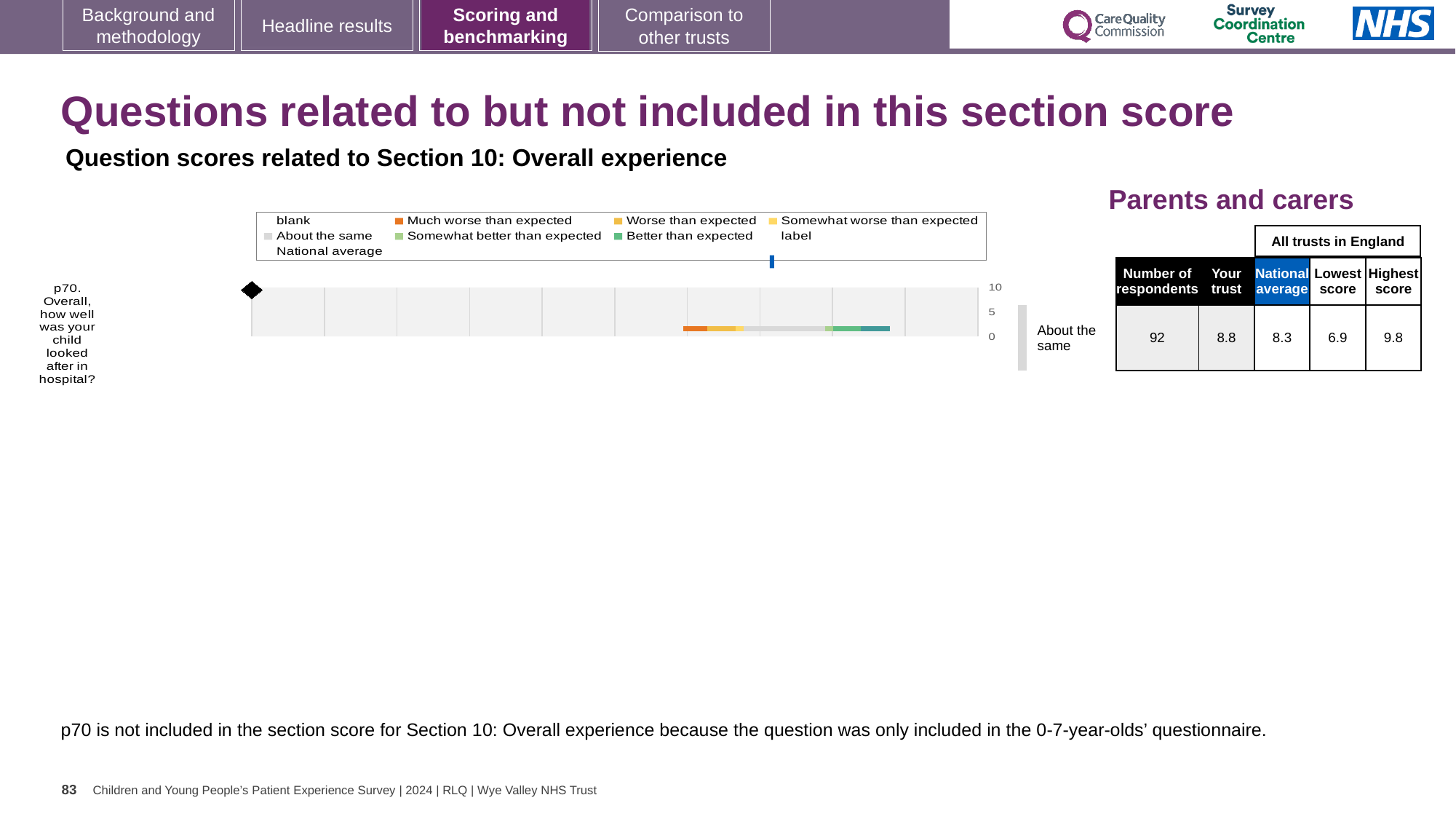
What kind of chart is used to show the p70 question score? bar chart Which is higher for p70, the 'Your trust' score or the national average? Your trust What is the 'Your trust' score for p70? 8.8 How many questions are plotted in the chart? 1 What is the national average score for p70? 8.3 Which category label is shown for the trust's p70 result? About the same Is the 'Your trust' score for p70 greater or less than 5? greater What is the highest score among all trusts in England for p70? 9.8 What is the difference between the highest and lowest scores for p70? 2.9 What is the lowest score among all trusts in England for p70? 6.9 Which question is plotted in the chart? p70. Overall, how well was your child looked after in hospital? How many respondents answered p70? 92